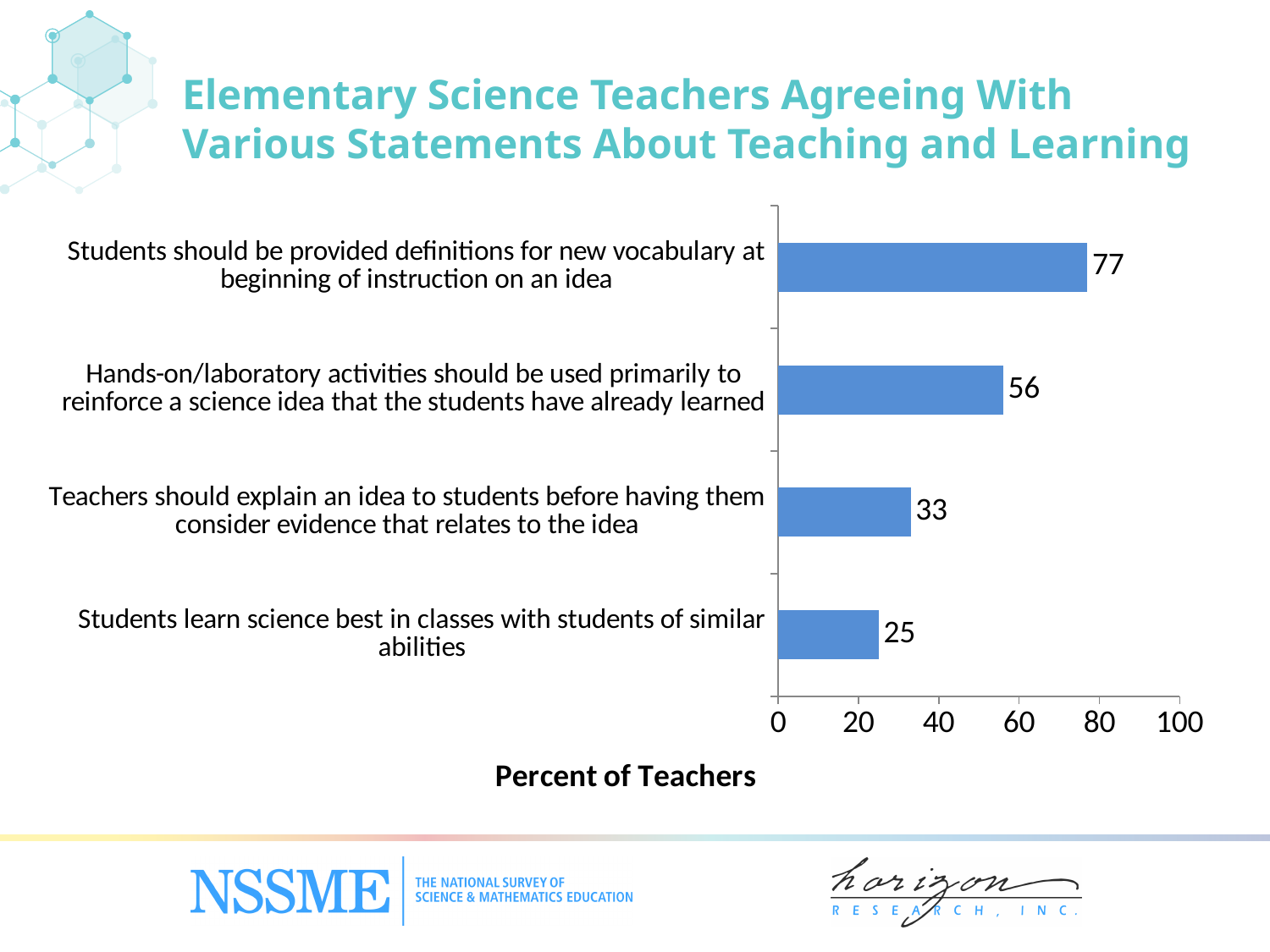
What is the difference in percent of teachers between the vocabulary definitions statement and the hands-on/laboratory activities statement? 21 What percent of teachers agree that students should be provided definitions for new vocabulary at the beginning of instruction on an idea? 77 What kind of chart is shown on the slide? Bar chart What percent of teachers agree that hands-on/laboratory activities should be used primarily to reinforce a science idea that the students have already learned? 56 What percent of teachers agree that students learn science best in classes with students of similar abilities? 25 What is the difference in percent of teachers between the statement about explaining an idea before considering evidence and the statement about students of similar abilities? 8 What is the label of the horizontal axis? Percent of Teachers Which statement has the highest percent of teachers agreeing? Students should be provided definitions for new vocabulary at beginning of instruction on an idea How many statements are shown in the chart? 4 Which statement has the lowest percent of teachers agreeing? Students learn science best in classes with students of similar abilities Which has a higher percent of teachers agreeing: the hands-on/laboratory activities statement or the statement about explaining an idea before considering evidence? Hands-on/laboratory activities should be used primarily to reinforce a science idea that the students have already learned What percent of teachers agree that teachers should explain an idea to students before having them consider evidence that relates to the idea? 33